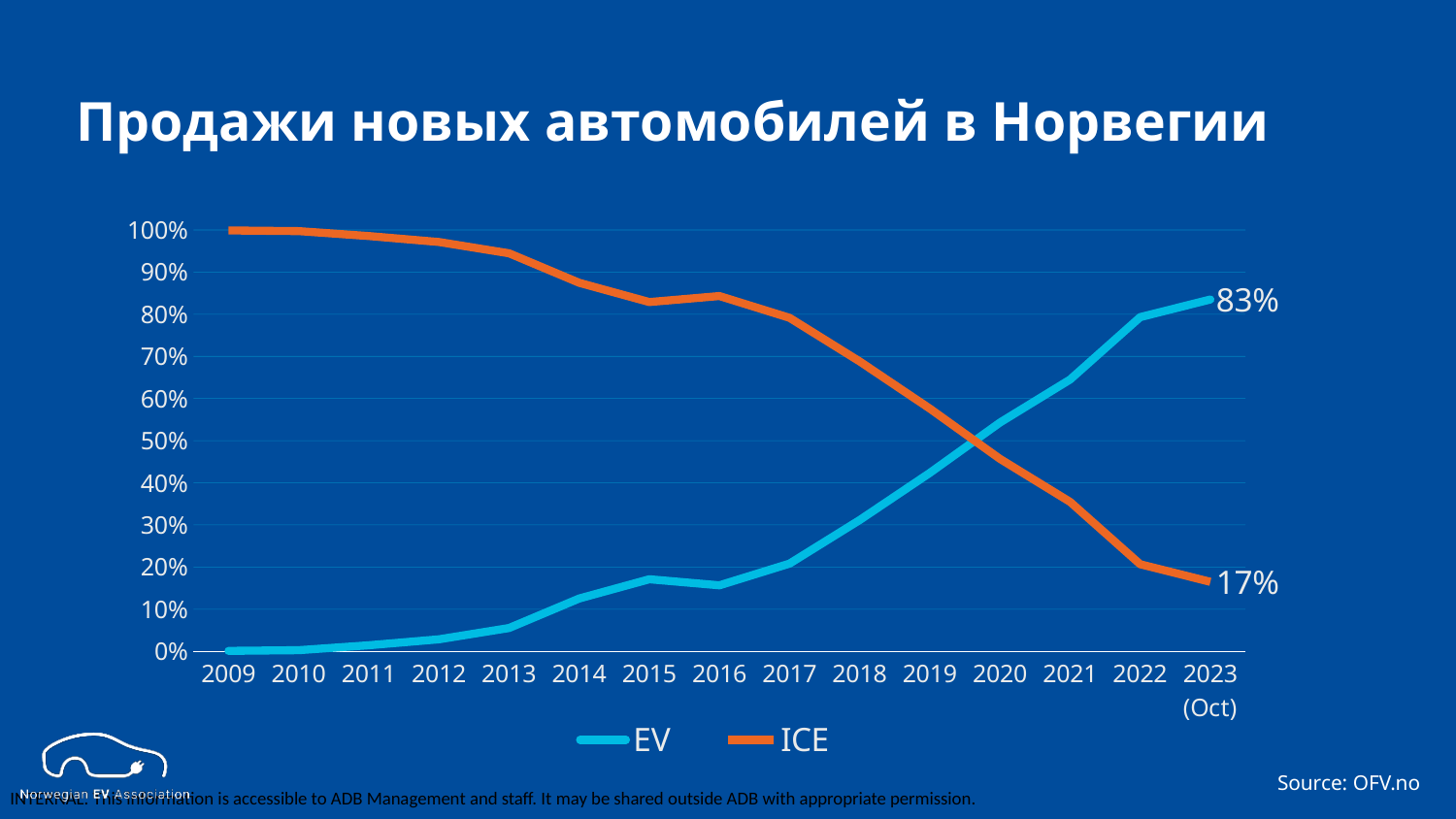
Is the value for ICE in 2013 greater or less than 90%? greater How many series does the legend list? 2 Which series has the larger value in 2023 (Oct), EV or ICE? EV What is the difference between the EV and ICE values in 2023 (Oct)? 66 percentage points What is the value for ICE in 2023 (Oct)? 17% What is the value for EV in 2023 (Oct)? 83% How many years are shown on the x axis? 15 Is the value for EV in 2013 greater or less than 10%? less Does the ICE series rise or fall from 2009 to 2023? Fall Is the value for ICE in 2021 greater or less than 40%? less Which series has the larger value in 2009, EV or ICE? ICE What kind of chart is shown on the slide? Line chart